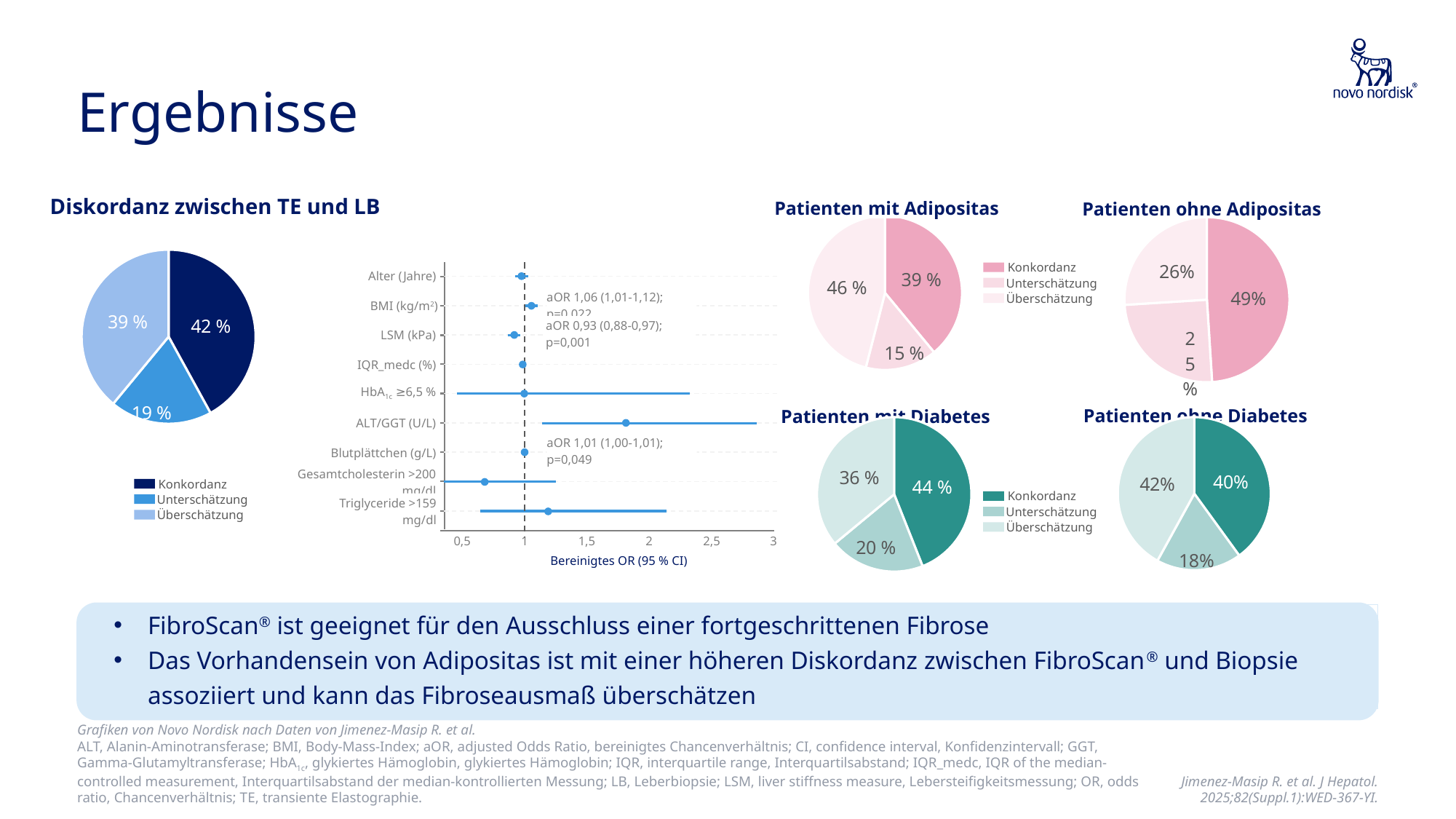
In the 'Patienten mit Adipositas' pie chart, what is the share for Überschätzung? 46 % In the forest plot with 'Bereinigtes OR (95 % CI)' on the x axis, how many variables are listed on the y axis? 9 In the 'Patienten ohne Diabetes' pie chart, what is the difference between the Konkordanz and Unterschätzung shares? 22% In the forest plot with 'Bereinigtes OR (95 % CI)' on the x axis, is the point estimate for ALT/GGT (U/L) greater or less than 1,5? greater In the 'Patienten mit Adipositas' pie chart, which category has the largest share? Überschätzung In the 'Diskordanz zwischen TE und LB' pie chart, which category has the smallest share? Unterschätzung In the 'Diskordanz zwischen TE und LB' pie chart, what is the share for Konkordanz? 42 % In the 'Diskordanz zwischen TE und LB' pie chart, what is the difference between the Konkordanz and Überschätzung shares? 3 % In the 'Patienten mit Diabetes' pie chart, what is the share for Unterschätzung? 20 % In the 'Patienten ohne Adipositas' pie chart, what is the share for Konkordanz? 49% In the 'Patienten ohne Diabetes' pie chart, which is larger, Konkordanz or Überschätzung? Überschätzung In the forest plot with 'Bereinigtes OR (95 % CI)' on the x axis, what is the aOR printed for LSM (kPa)? 0,93 (0,88-0,97)